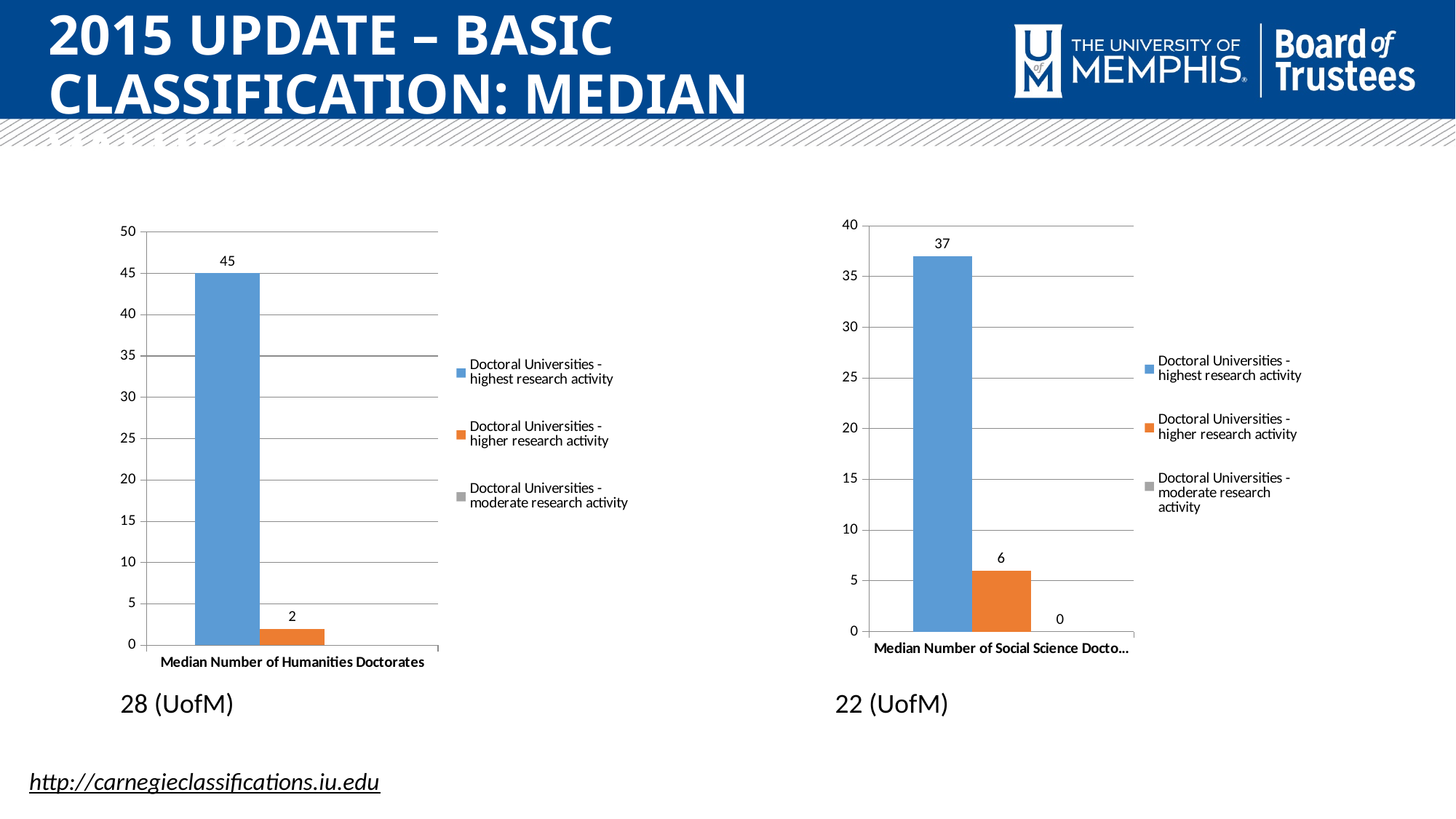
How many series does the legend of the right chart (Median Number of Social Science Doctorates) list? 3 On the right chart (Median Number of Social Science Doctorates), which series has the highest value? Doctoral Universities - highest research activity Which is larger: the highest research activity value on the left chart (Humanities) or the highest research activity value on the right chart (Social Science)? Left chart (Humanities), 45 What kind of chart is the left chart (Median Number of Humanities Doctorates)? bar chart On the left chart (Median Number of Humanities Doctorates), what is the value for Doctoral Universities - higher research activity? 2 On the left chart (Median Number of Humanities Doctorates), is the value for Doctoral Universities - highest research activity greater or less than 40? greater On the right chart (Median Number of Social Science Doctorates), what is the difference between the highest research activity value and the higher research activity value? 31 On the right chart (Median Number of Social Science Doctorates), what is the value for Doctoral Universities - highest research activity? 37 On the right chart (Median Number of Social Science Doctorates), what is the value for Doctoral Universities - moderate research activity? 0 On the left chart (Median Number of Humanities Doctorates), what is the difference between the highest research activity value and the higher research activity value? 43 On the right chart (Median Number of Social Science Doctorates), what is the value for Doctoral Universities - higher research activity? 6 On the left chart (Median Number of Humanities Doctorates), what is the value for Doctoral Universities - highest research activity? 45